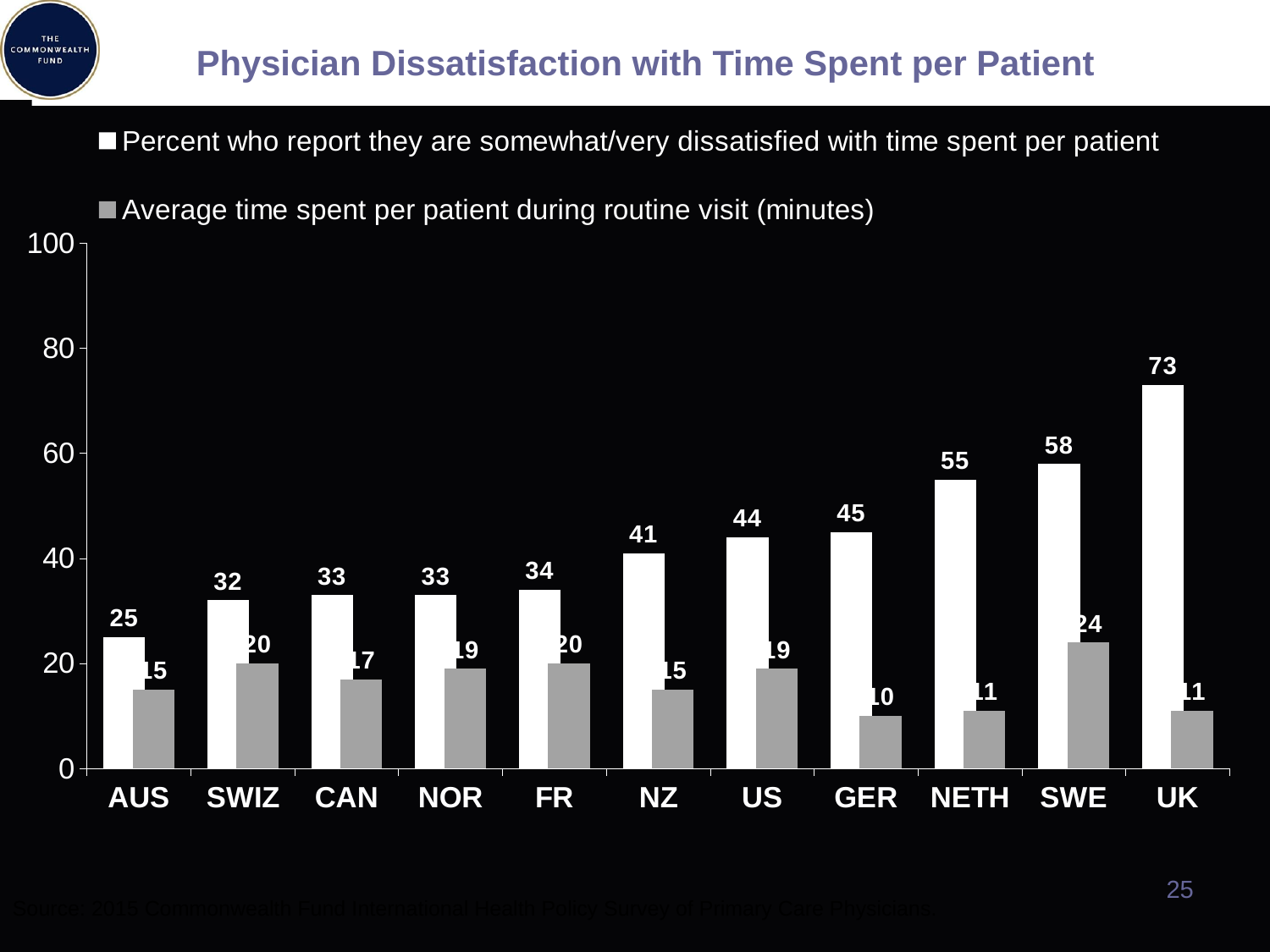
What is the difference between the percent dissatisfied in the UK and in Australia (AUS)? 48 Which is larger: the average minutes per patient in Switzerland (SWIZ) or in Canada (CAN)? SWIZ What percent of physicians in the UK report they are somewhat/very dissatisfied with time spent per patient? 73 Which country has the highest percent of physicians dissatisfied with time spent per patient? UK What is the average time spent per patient during a routine visit (minutes) in Sweden (SWE)? 24 How many countries are shown on the x axis of the chart? 11 How many series does the legend list? 2 What kind of chart is shown on the slide? bar chart Is the percent dissatisfied for the Netherlands (NETH) greater or less than 60? less Do the percent-dissatisfied values rise or fall moving from AUS to UK along the x axis? rise Which country has the lowest average time spent per patient during a routine visit? GER Which country has the lowest percent of physicians dissatisfied with time spent per patient? AUS